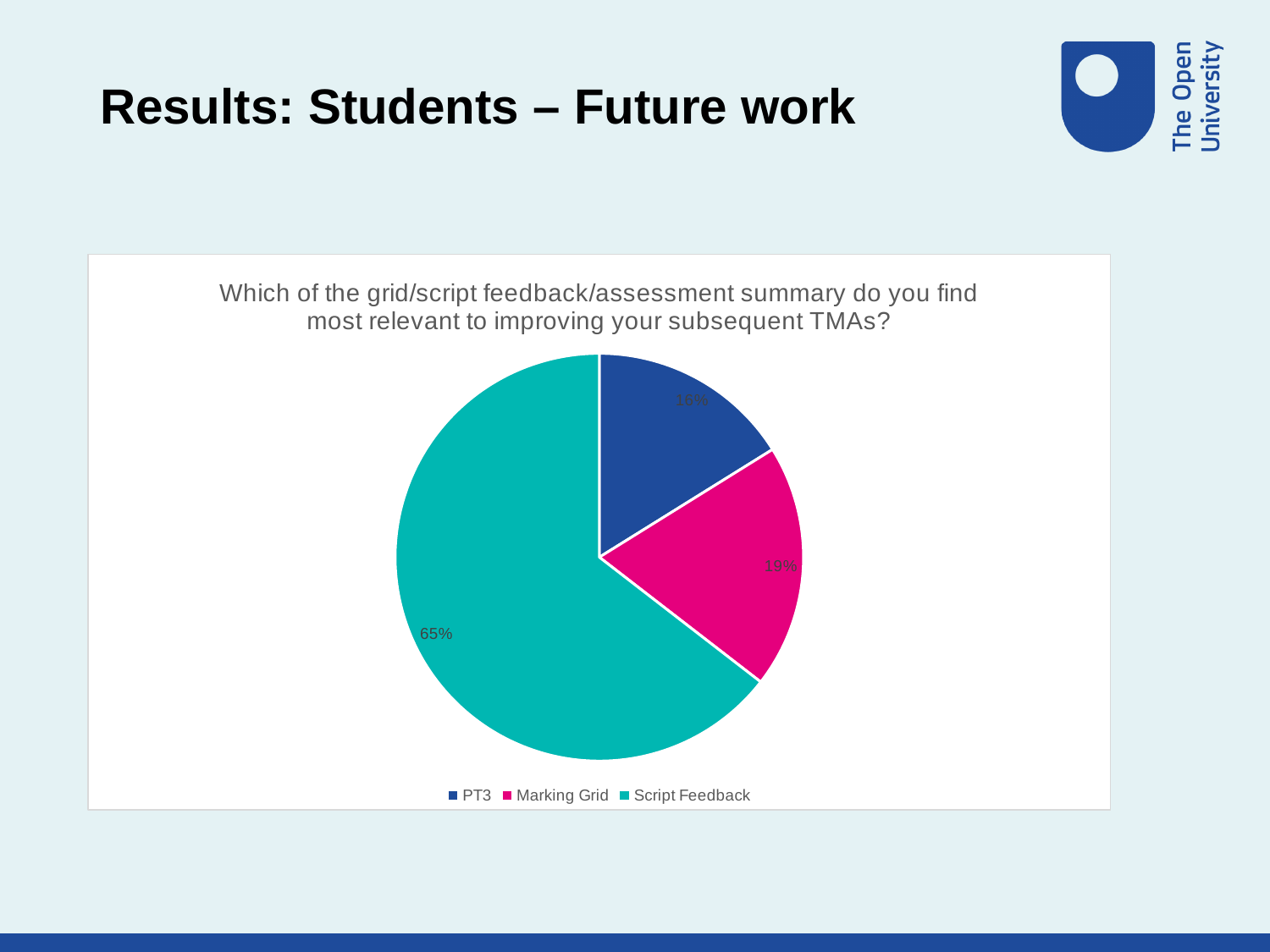
Which option has the smallest share of the pie? PT3 Which option has the largest share of the pie? Script Feedback How many entries does the legend list? 3 Which is larger, the share for Script Feedback or the share for PT3? Script Feedback What is the difference in percentage points between Marking Grid and PT3? 3 What percentage of students chose Script Feedback? 65% What percentage of students chose Marking Grid? 19% What percentage of students chose PT3? 16% How many slices does the pie chart have? 3 What type of chart is shown on the slide? pie chart What colour is the Marking Grid slice? pink What is the difference in percentage points between Script Feedback and Marking Grid? 46